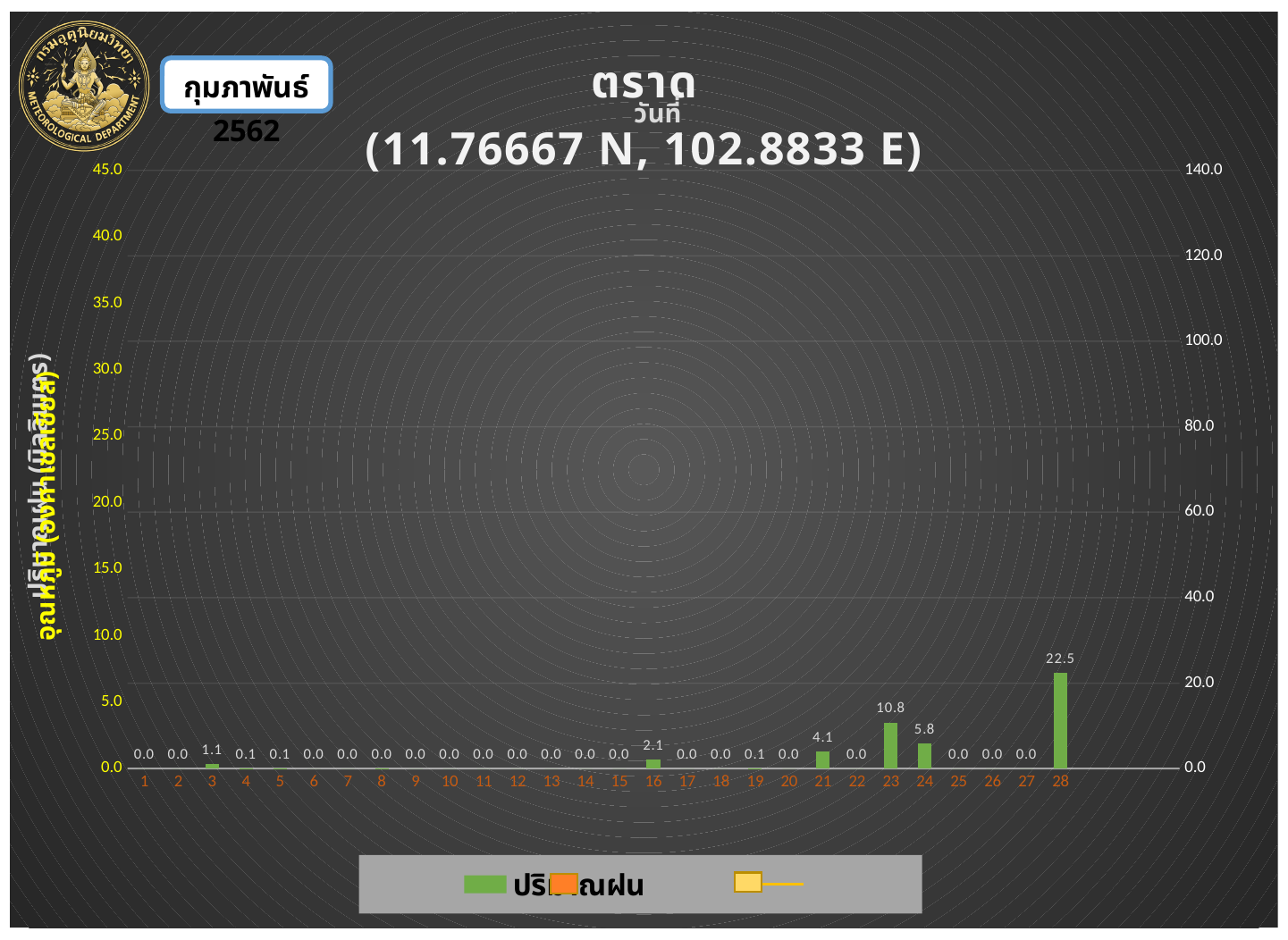
What is the difference between the values for day 23 and day 24? 5.0 Which day has the highest value? 28 What is the value for day 28? 22.5 What is the value for day 16? 2.1 What is the value for day 23? 10.8 What is the difference between the values for day 28 and day 23? 11.7 What kind of chart is this? bar chart What is the maximum value shown on the left y axis? 45.0 How many days are shown on the x axis? 28 Which is larger, the value for day 21 or the value for day 24? day 24 What is the value for day 3? 1.1 What is the value for day 21? 4.1